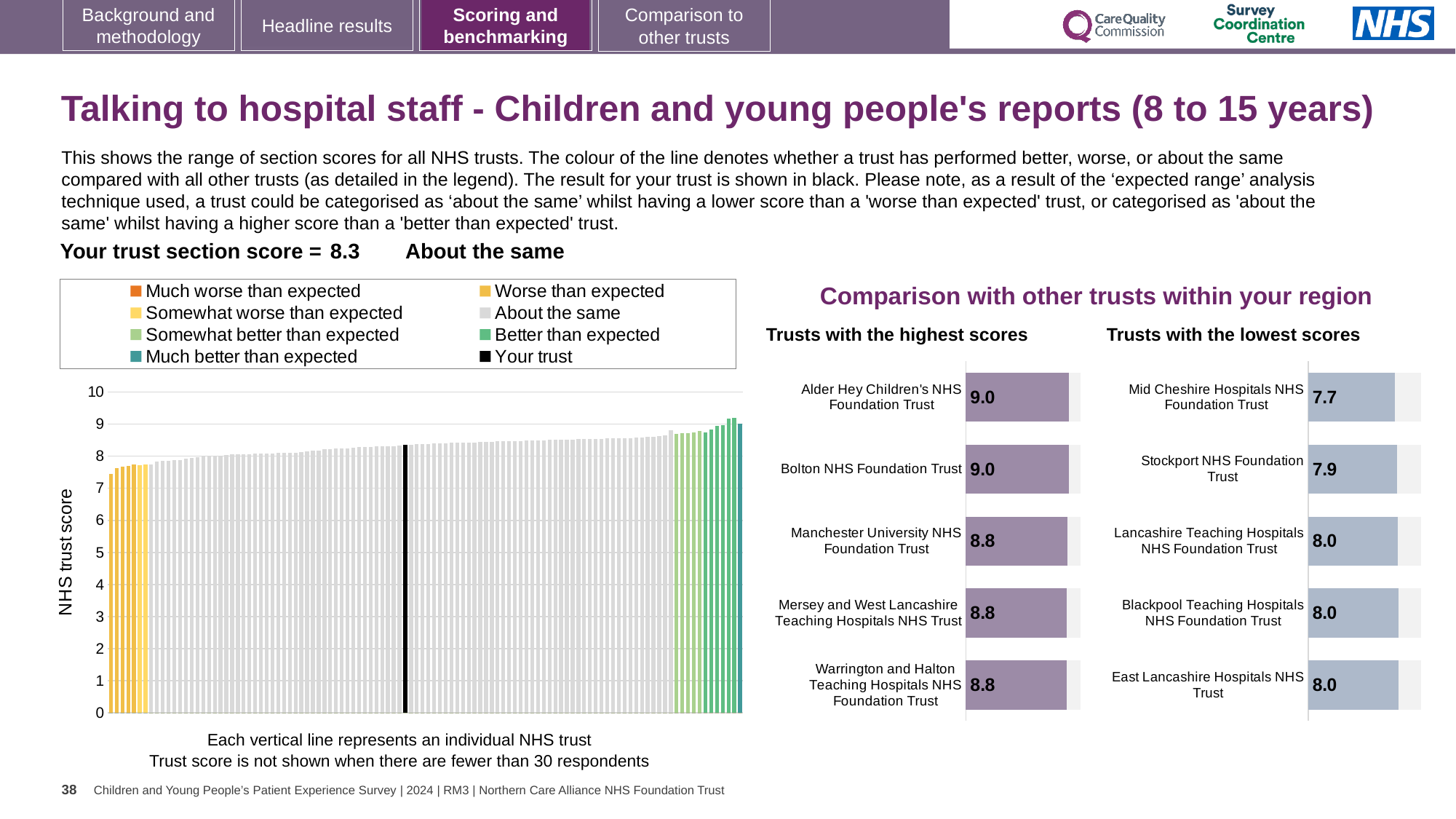
How many entries does the legend of the main chart on the left list? 8 In the 'Trusts with the lowest scores' chart, which trust has the lowest score? Mid Cheshire Hospitals NHS Foundation Trust In the 'Trusts with the highest scores' chart, what is the difference between the scores of Bolton NHS Foundation Trust and Warrington and Halton Teaching Hospitals NHS Foundation Trust? 0.2 How many trusts are shown in the 'Trusts with the highest scores' chart? 5 In the 'Trusts with the lowest scores' chart, what is the difference between the scores of Stockport NHS Foundation Trust and Mid Cheshire Hospitals NHS Foundation Trust? 0.2 Which is larger: the score for Bolton NHS Foundation Trust in the 'Trusts with the highest scores' chart or the score for Stockport NHS Foundation Trust in the 'Trusts with the lowest scores' chart? Bolton NHS Foundation Trust In the main chart on the left showing all NHS trusts, what is your trust's section score? 8.3 What kind of chart is the main chart on the left showing all NHS trusts? Bar chart In the 'Trusts with the lowest scores' chart, what is the score for Stockport NHS Foundation Trust? 7.9 In the 'Trusts with the highest scores' chart, what is the score for Manchester University NHS Foundation Trust? 8.8 In the main chart on the left showing all NHS trusts, is the value for the lowest-scoring trust greater or less than 7? greater In the 'Trusts with the highest scores' chart, what is the score for Alder Hey Children's NHS Foundation Trust? 9.0